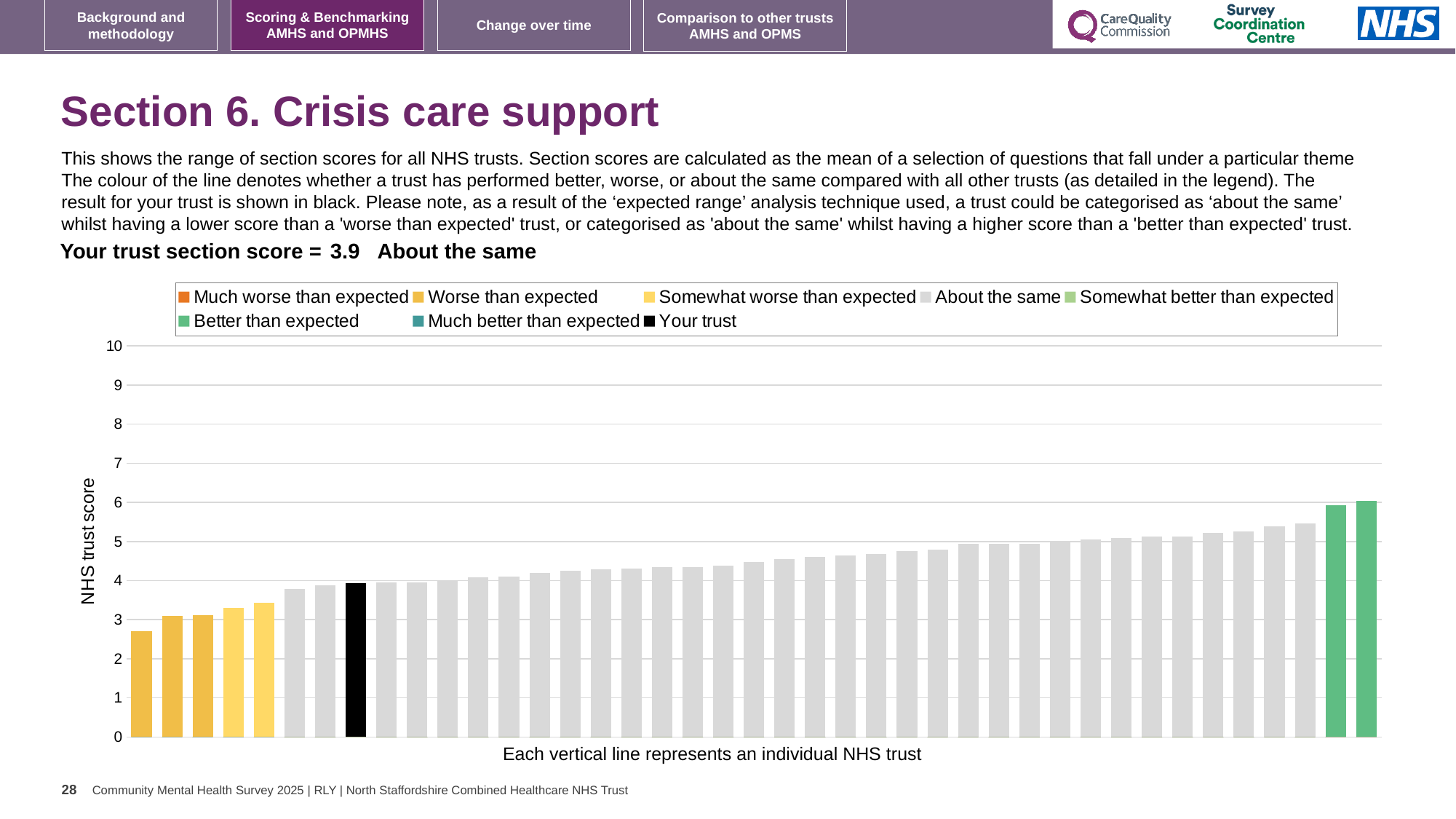
How many bars are coloured green (Better than expected)? 2 What type of chart is shown on the slide? bar chart How many entries does the chart legend list? 8 What is the label on the y axis of the chart? NHS trust score Is the value of the leftmost (lowest) bar greater or less than 3? less Is the value of the tallest bar greater or less than 5? greater Do the bar values rise or fall from left to right along the x axis? rise How many bars are coloured in the 'Worse than expected' colour? 3 What is the section score for your trust shown on the slide? 3.9 Which category is your trust placed in for this section? About the same Is your trust's bar higher or lower than the rightmost bar? lower